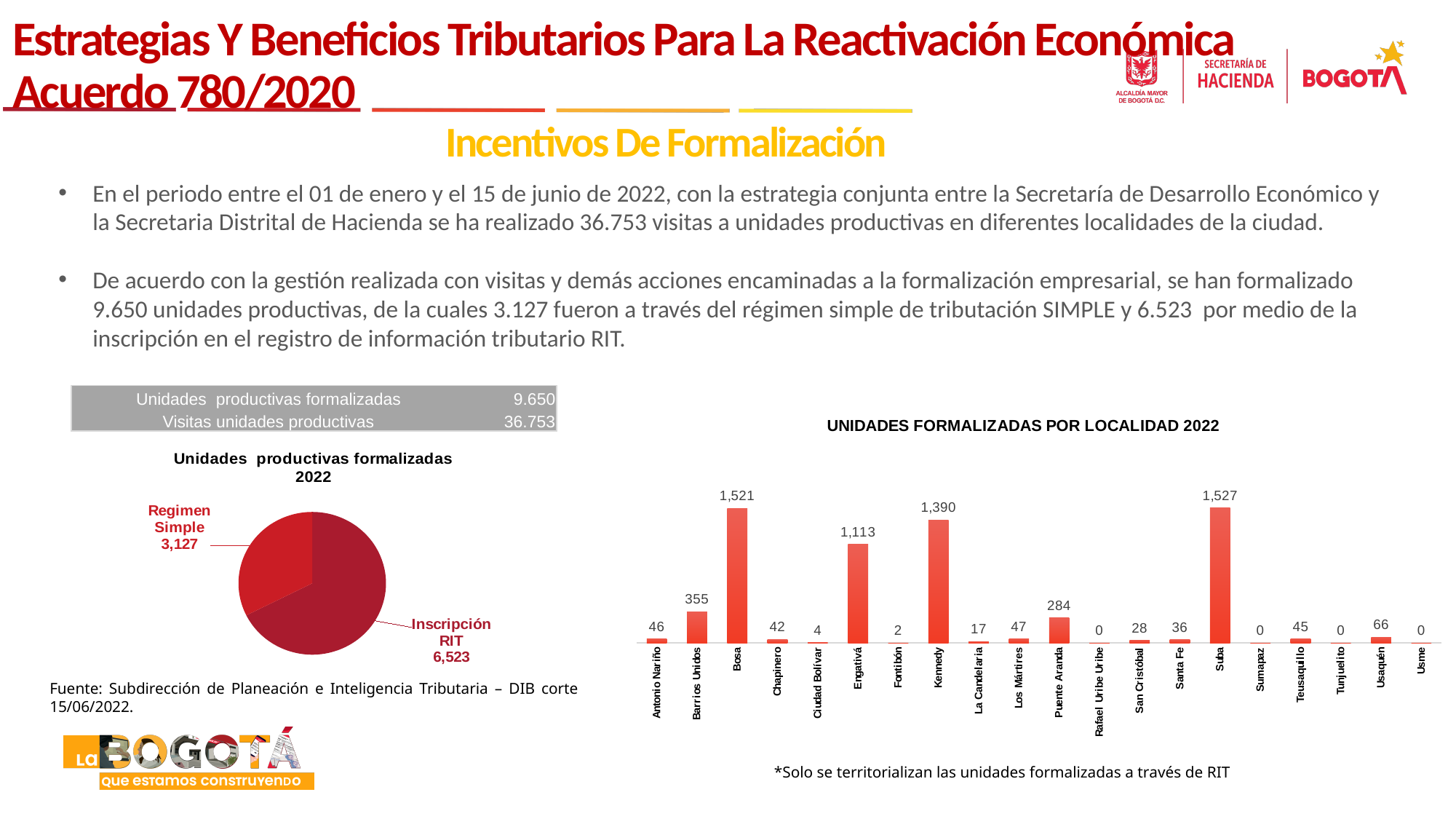
In the chart 'Unidades productivas formalizadas 2022', which slice is larger, Regimen Simple or Inscripción RIT? Inscripción RIT In the chart 'UNIDADES FORMALIZADAS POR LOCALIDAD 2022', how many localities are shown on the x axis? 20 In the chart 'Unidades productivas formalizadas 2022', what is the difference between Inscripción RIT and Regimen Simple? 3,396 What kind of chart is 'UNIDADES FORMALIZADAS POR LOCALIDAD 2022'? Bar chart In the chart 'UNIDADES FORMALIZADAS POR LOCALIDAD 2022', which locality has the highest value? Suba In the chart 'UNIDADES FORMALIZADAS POR LOCALIDAD 2022', what is the value for Puente Aranda? 284 In the chart 'UNIDADES FORMALIZADAS POR LOCALIDAD 2022', what is the value for Kennedy? 1,390 In the chart 'Unidades productivas formalizadas 2022', what is the value for Regimen Simple? 3,127 In the chart 'UNIDADES FORMALIZADAS POR LOCALIDAD 2022', what is the difference between Kennedy and Engativá? 277 What kind of chart is 'Unidades productivas formalizadas 2022'? Pie chart In the chart 'UNIDADES FORMALIZADAS POR LOCALIDAD 2022', which is larger, Barrios Unidos or Usaquén? Barrios Unidos In the chart 'Unidades productivas formalizadas 2022', what is the value for Inscripción RIT? 6,523